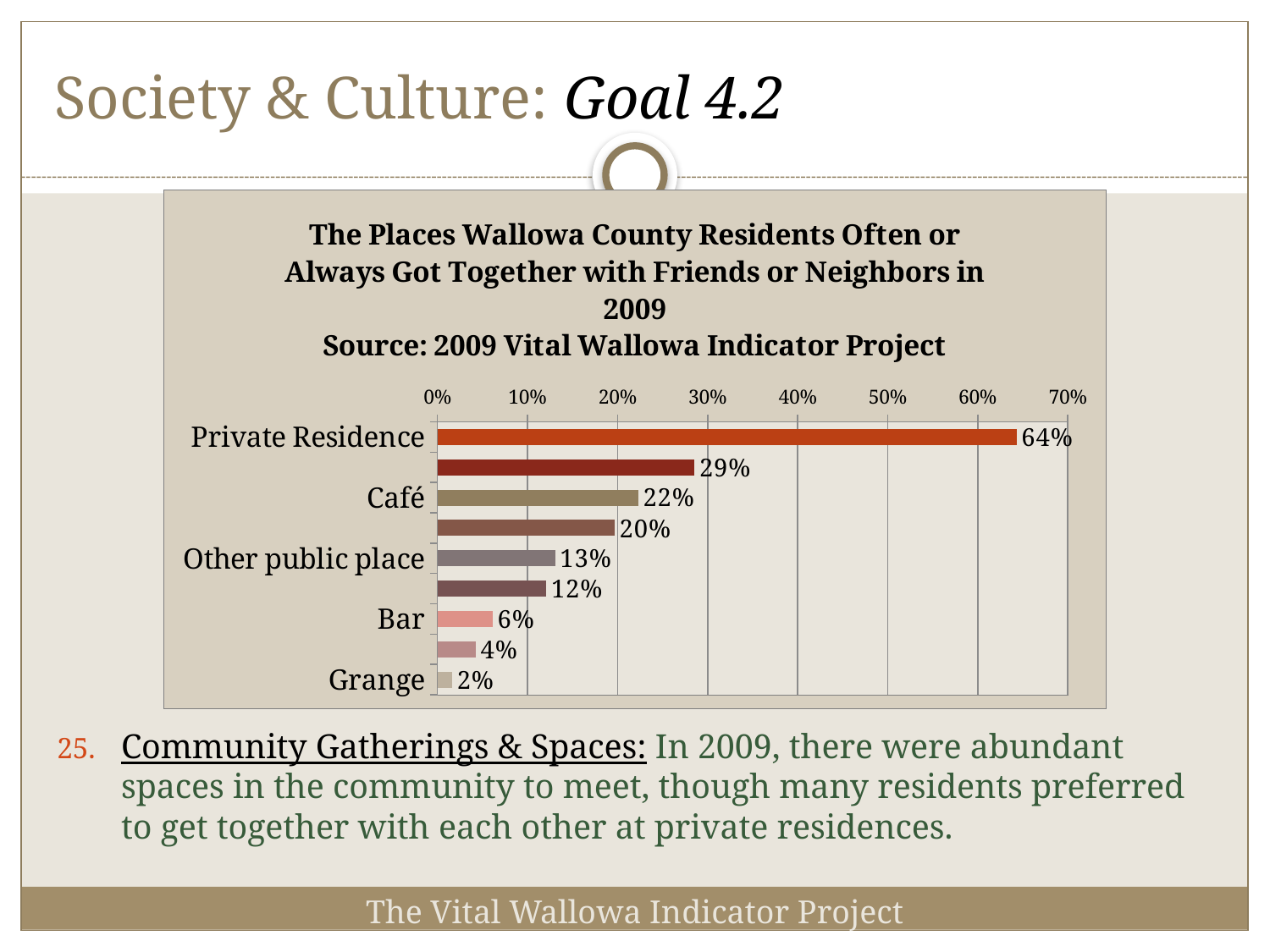
Which place has the lowest percentage? Grange What is the value shown for Café? 22% What is the value shown for Grange? 2% What is the difference between the values for Private Residence and Café? 42% Which is larger, the value for Bar or the value for Other public place? Other public place How many bars are plotted in the chart? 9 Which place has the highest percentage? Private Residence What is the value shown for Other public place? 13% What kind of chart is shown on the slide? Bar chart What is the value shown for Bar? 6% What percentage of residents often or always got together at a Private Residence? 64% Is the value for Private Residence greater or less than 60%? greater